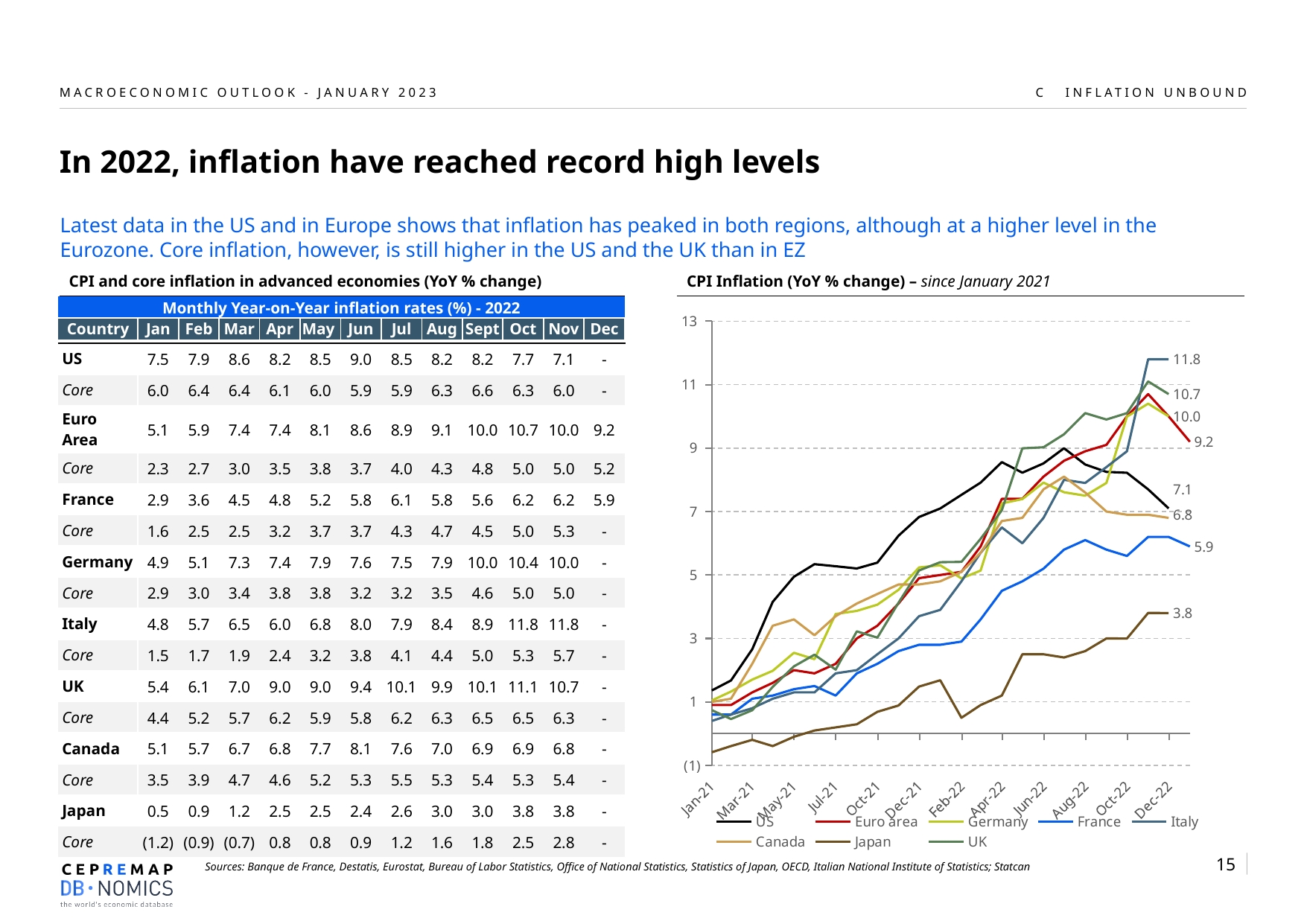
In the CPI Inflation line chart, what is the latest labelled value for Italy? 11.8 In the CPI Inflation line chart, what is the latest labelled value for Japan? 3.8 In the CPI Inflation line chart, is the value for Japan in Jan-21 greater or less than 1? less In the CPI Inflation line chart, what is the difference between the latest labelled values for Italy and Japan? 8.0 In the CPI Inflation line chart, which country has the highest latest labelled value? Italy In the CPI Inflation line chart, does the Japan line generally rise or fall from Jan-21 to the end of the series? rise What is the first month shown on the x axis of the CPI Inflation line chart? Jan-21 In the CPI Inflation line chart, which has the larger latest labelled value, the Euro area or the US? Euro area In the CPI Inflation line chart, which country has the lowest latest labelled value? Japan How many series does the legend of the CPI Inflation line chart list? 8 In the CPI Inflation line chart, what is the latest labelled value for the Euro area? 9.2 What kind of chart is the 'CPI Inflation (YoY % change) – since January 2021' chart? line chart